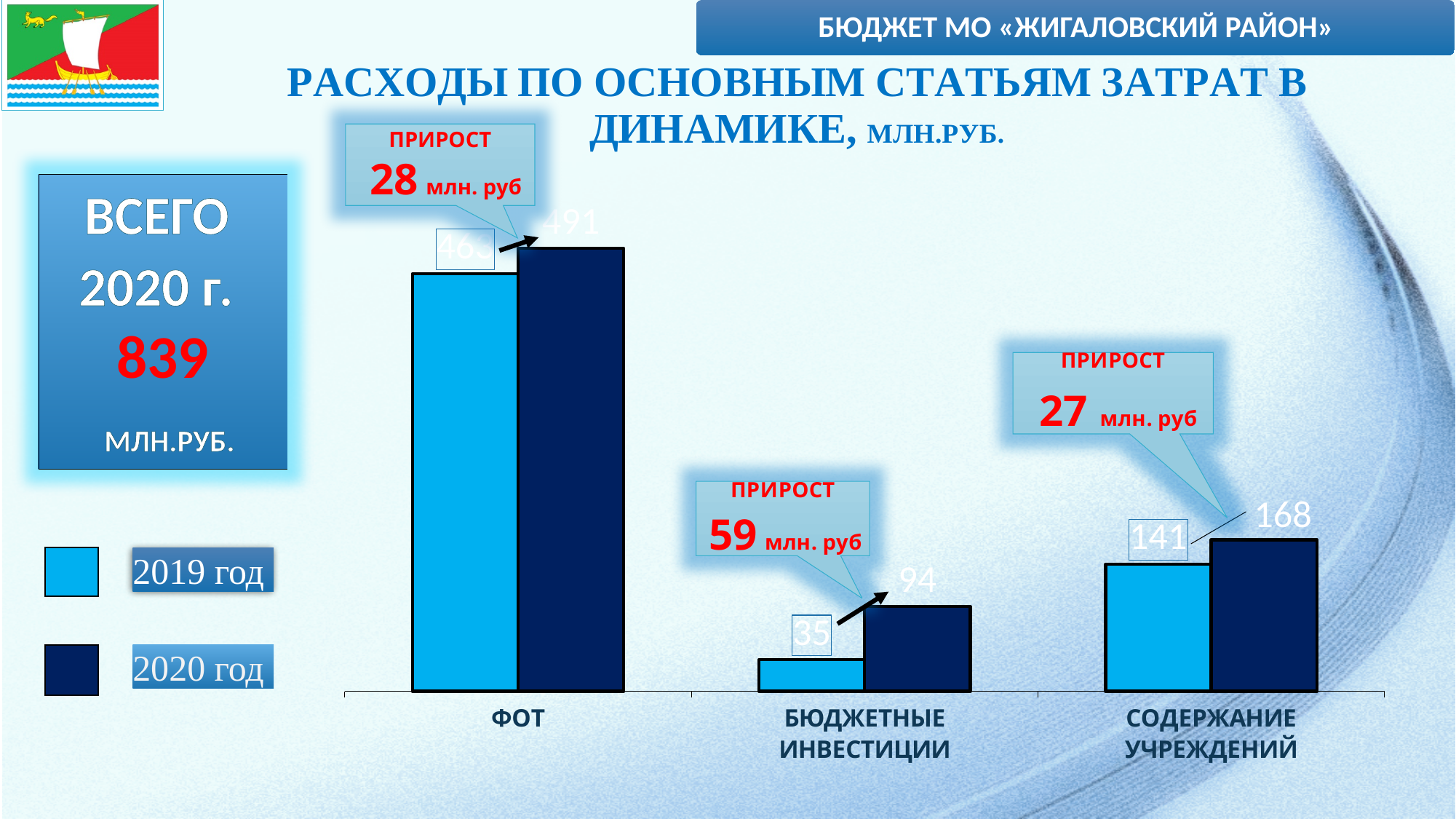
What is the value for ФОТ in 2020 год? 491 What is the value for БЮДЖЕТНЫЕ ИНВЕСТИЦИИ in 2019 год? 35 What type of chart is shown on the slide? bar chart What is the value for БЮДЖЕТНЫЕ ИНВЕСТИЦИИ in 2020 год? 94 What is the value for СОДЕРЖАНИЕ УЧРЕЖДЕНИЙ in 2019 год? 141 What is the value for СОДЕРЖАНИЕ УЧРЕЖДЕНИЙ in 2020 год? 168 What is the difference between the 2020 год and 2019 год values for СОДЕРЖАНИЕ УЧРЕЖДЕНИЙ? 27 Which category has the lowest value in 2019 год? БЮДЖЕТНЫЕ ИНВЕСТИЦИИ Which category has the highest value in 2020 год? ФОТ How many series does the legend list? 2 How many categories are shown on the x axis of the chart? 3 Which is larger: the 2020 год value for БЮДЖЕТНЫЕ ИНВЕСТИЦИИ or the 2019 год value for СОДЕРЖАНИЕ УЧРЕЖДЕНИЙ? 2019 год value for СОДЕРЖАНИЕ УЧРЕЖДЕНИЙ